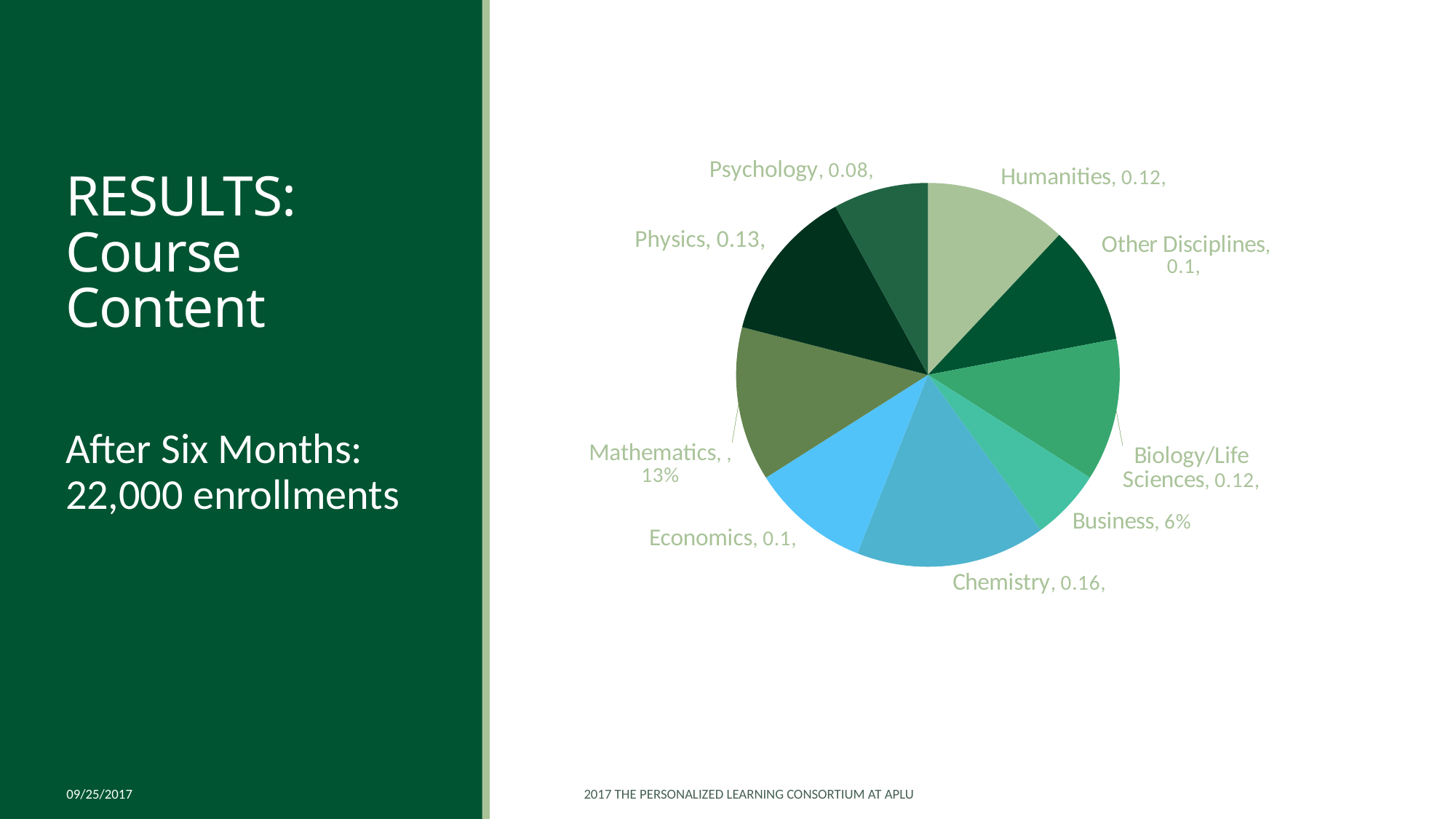
What value is shown for Humanities in the pie chart? 0.12 What value is shown for Mathematics in the pie chart? 13% What is the difference between the values for Chemistry and Psychology? 0.08 Which is larger in the pie chart, Chemistry or Psychology? Chemistry What kind of chart is shown on the slide? pie chart What is the difference between the values for Physics and Other Disciplines? 0.03 How many slices does the pie chart have? 9 Which category has the smallest slice of the pie chart? Business What value is shown for Psychology in the pie chart? 0.08 What value is shown for Chemistry in the pie chart? 0.16 What value is shown for Business in the pie chart? 6% Which category has the largest slice of the pie chart? Chemistry